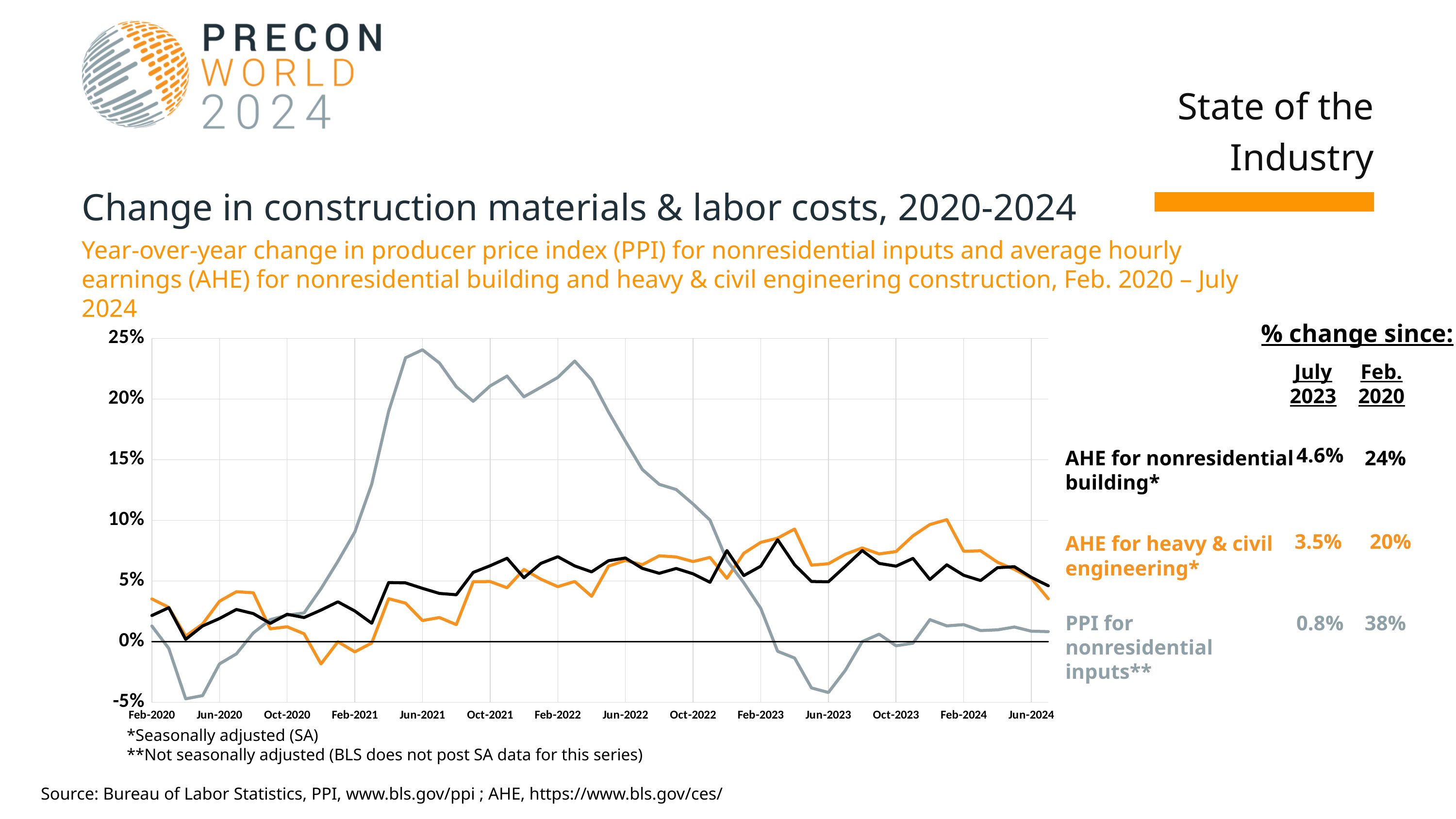
Which is larger: the % change since July 2023 for AHE for nonresidential building or for AHE for heavy & civil engineering? AHE for nonresidential building Is the value of the PPI for nonresidential inputs line around Jun-2023 greater or less than 0%? less Which series has the smallest % change since July 2023? PPI for nonresidential inputs Does the PPI for nonresidential inputs line rise or fall between Jun-2021 and Jun-2023? fall What is the difference between the % change since Feb. 2020 for AHE for nonresidential building and for AHE for heavy & civil engineering? 4 percentage points What is the % change since July 2023 for AHE for nonresidential building? 4.6% What is the % change since Feb. 2020 for AHE for heavy & civil engineering? 20% Which series has the largest % change since Feb. 2020? PPI for nonresidential inputs What is the % change since Feb. 2020 for PPI for nonresidential inputs? 38% How many series are plotted on the chart? 3 What kind of chart is shown on the slide? line chart Is the peak value of the PPI for nonresidential inputs line around Jun-2021 greater or less than 20%? greater